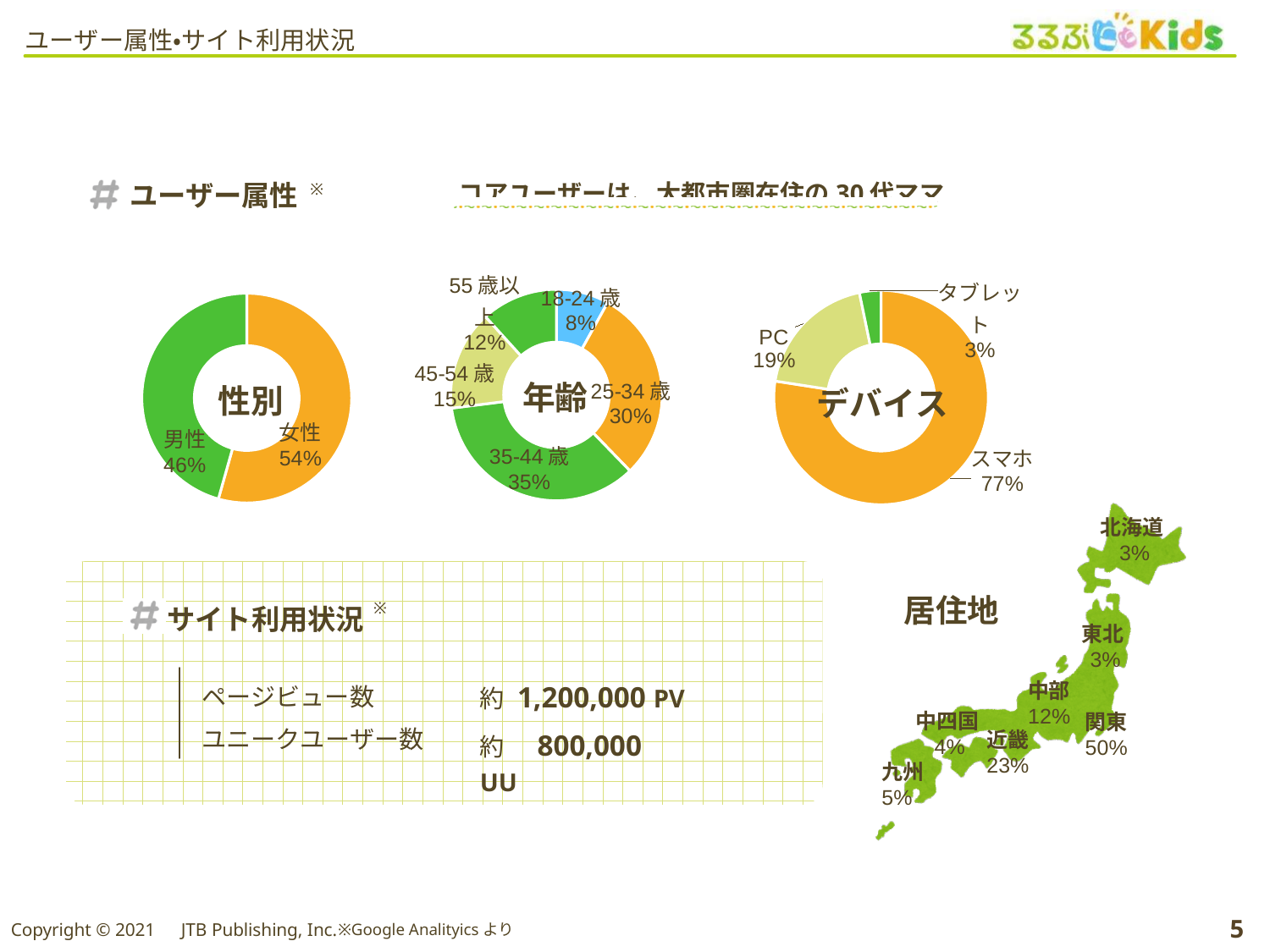
In the 年齢 chart, what is the share for 35-44 歳? 35% In the 性別 chart, which is larger, 男性 or 女性? 女性 In the デバイス chart, what is the share for PC? 19% In the 性別 chart, what is the share for 男性? 46% In the 年齢 chart, which age group has the largest share? 35-44 歳 In the 年齢 chart, what is the difference between the shares for 25-34 歳 and 45-54 歳? 15% What kind of chart is the デバイス chart? Donut (pie) chart In the デバイス chart, what is the share for スマホ? 77% In the デバイス chart, which device has the smallest share? タブレット In the 年齢 chart, which age group has the smallest share? 18-24 歳 In the 年齢 chart, how many age groups are shown? 5 In the 性別 chart, what is the share for 女性? 54%